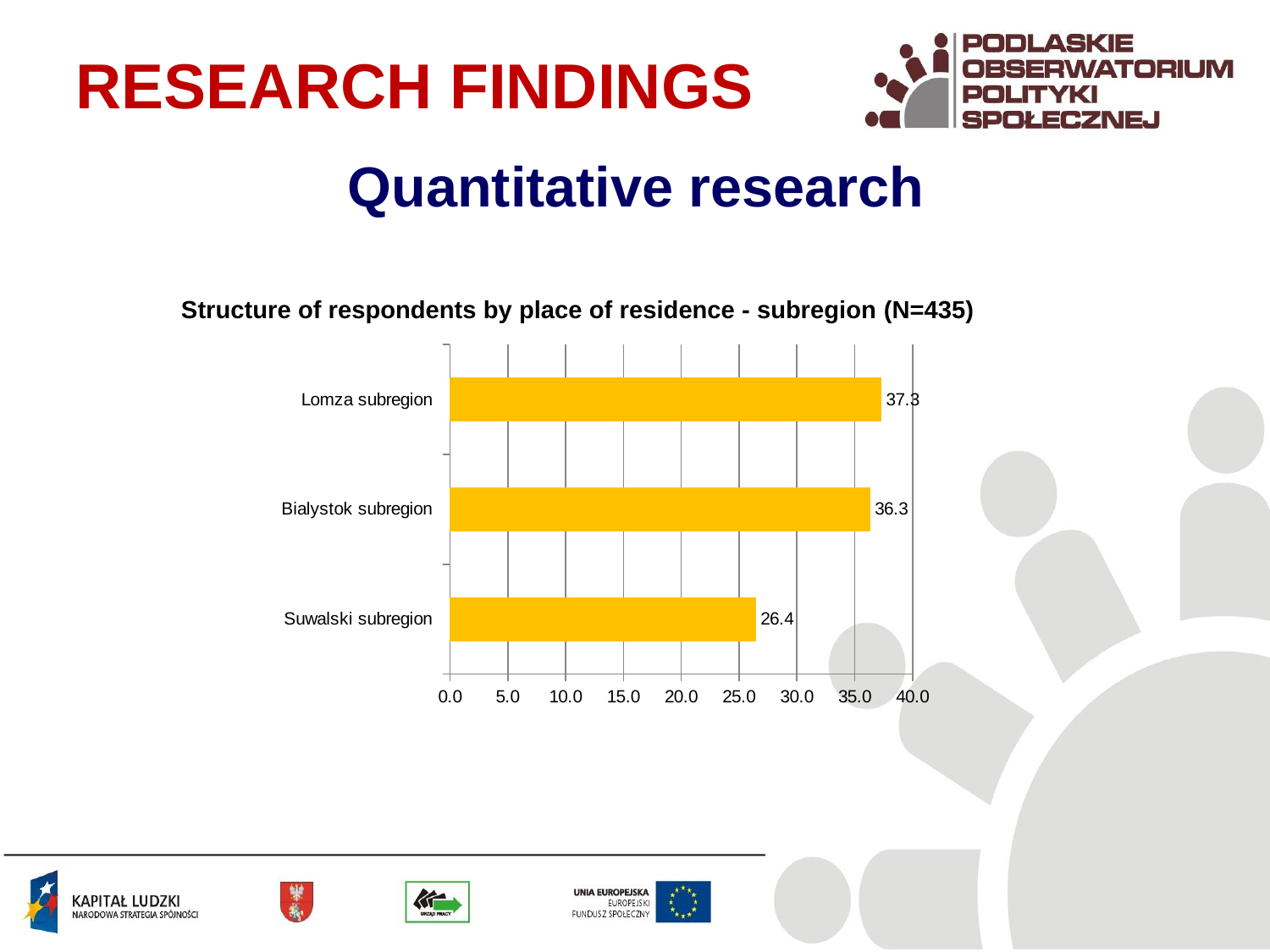
Is the value for Suwalski subregion greater or less than 30.0? less What is the value for Bialystok subregion? 36.3 What is the value for Suwalski subregion? 26.4 Which is larger, the value for Bialystok subregion or Suwalski subregion? Bialystok subregion What is the value for Lomza subregion? 37.3 How many subregions are shown in the chart? 3 What is the difference between the values for Lomza subregion and Suwalski subregion? 10.9 What kind of chart is shown on the slide? bar chart What is the difference between the values for Bialystok subregion and Suwalski subregion? 9.9 Which subregion has the highest value? Lomza subregion What is the title of the chart? Structure of respondents by place of residence - subregion (N=435) Which subregion has the lowest value? Suwalski subregion